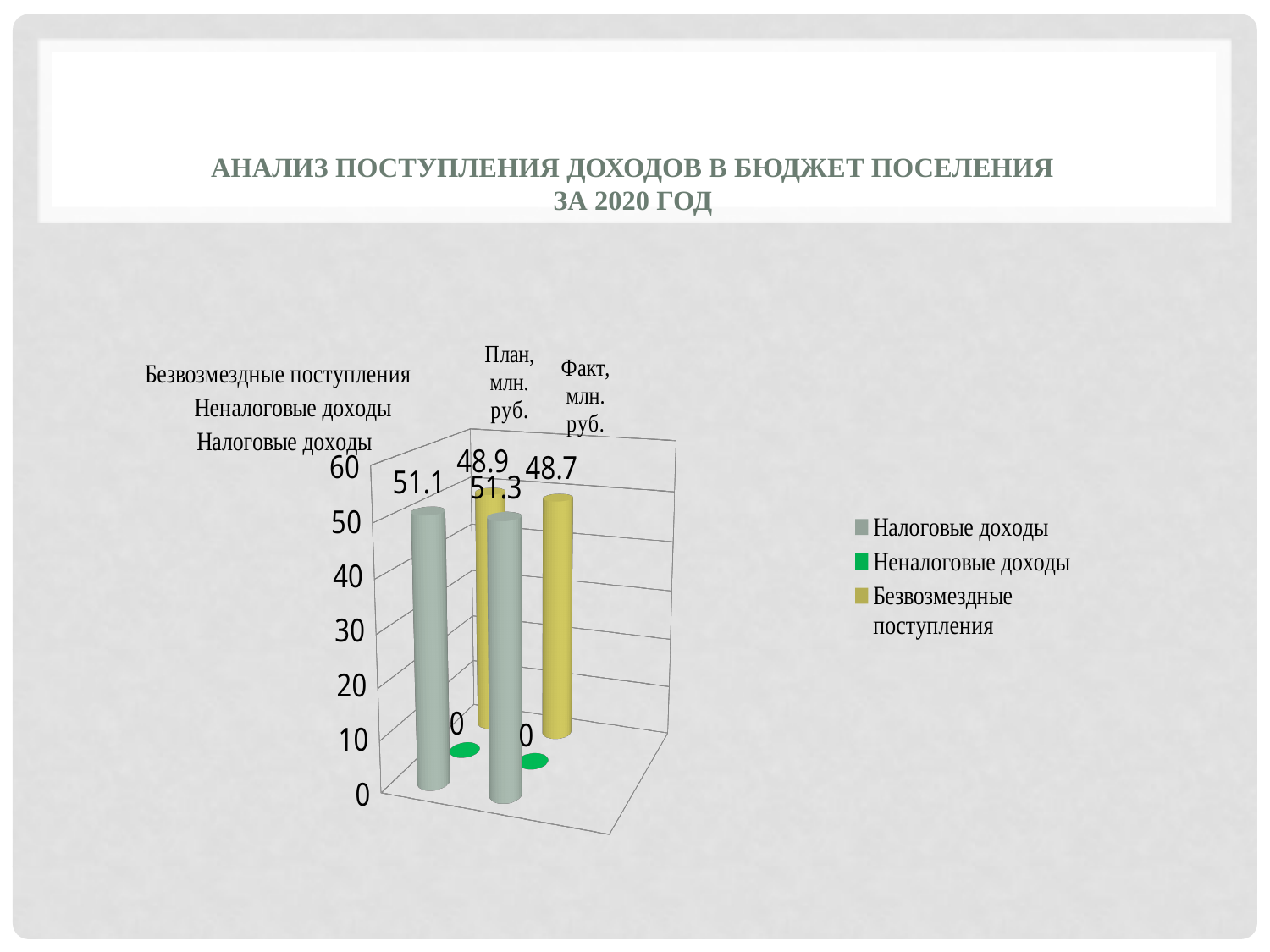
What is the difference between the Безвозмездные поступления values for План and Факт? 0.2 What is the value of Неналоговые доходы for План, млн. руб.? 0 What is the value of Безвозмездные поступления for План, млн. руб.? 48.9 What is the value of Налоговые доходы for План, млн. руб.? 51.1 What is the difference between the Налоговые доходы values for Факт and План? 0.2 What is the value of Безвозмездные поступления for Факт, млн. руб.? 48.7 What is the value of Налоговые доходы for Факт, млн. руб.? 51.3 What kind of chart is shown on the slide? bar chart Which series has the lowest value for Факт, млн. руб.? Неналоговые доходы How many series does the legend list? 3 What is the title of the slide? Анализ поступления доходов в бюджет поселения за 2020 год Is the value of Налоговые доходы for План greater or less than 50? greater